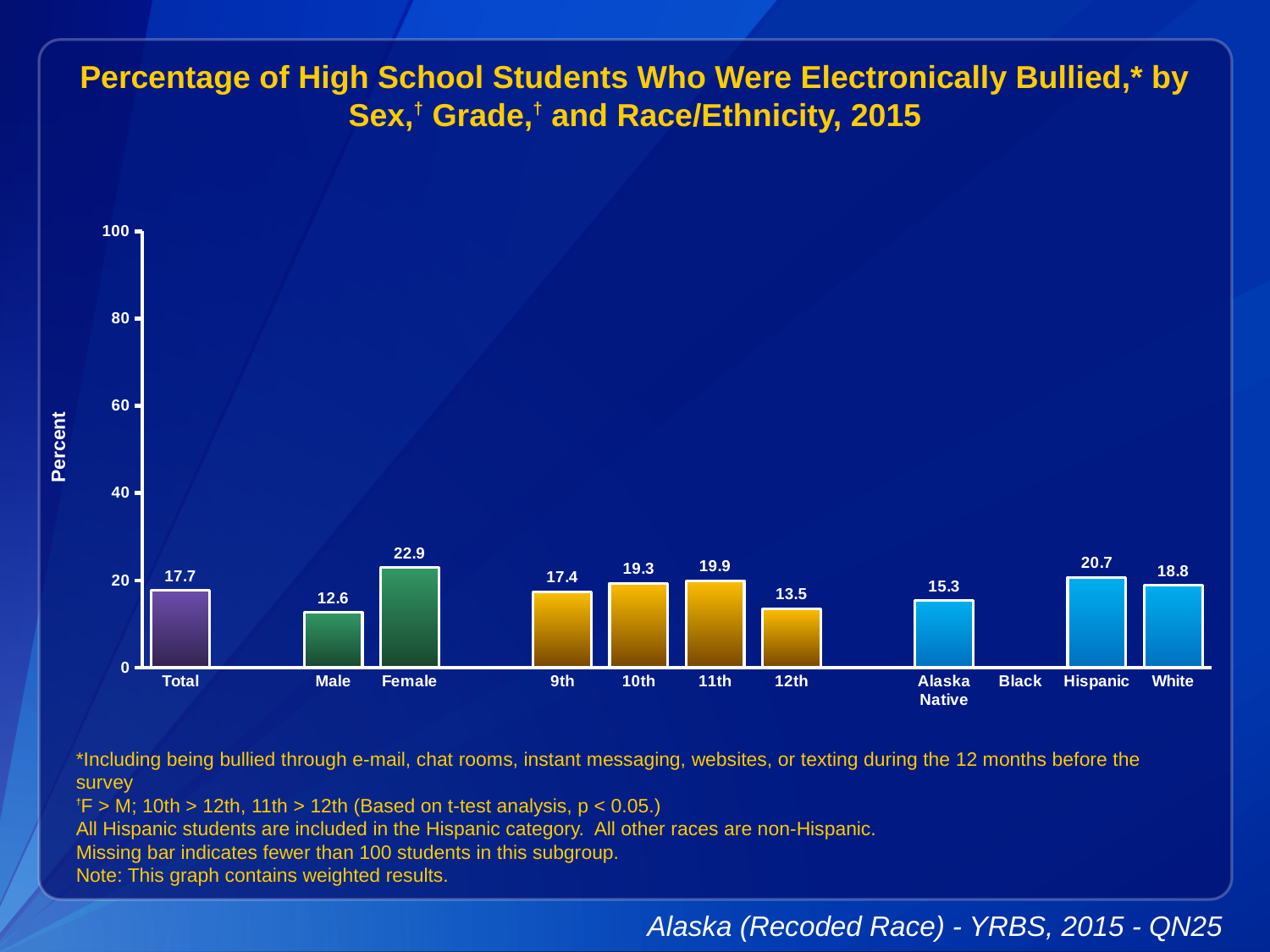
Which category has the lowest percentage of students who were electronically bullied? Male What is the value shown for Female students? 22.9 Which category has the highest percentage of students who were electronically bullied? Female What is the value shown for 12th grade students? 13.5 Is the value for 11th grade students greater or less than 20? less Which is larger, the value for Hispanic students or the value for White students? Hispanic What is the percentage of students who were electronically bullied in the Total category? 17.7 What is the difference between the Female and Male percentages? 10.3 Which race/ethnicity category has no bar shown on the chart? Black What kind of chart is shown on the slide? bar chart How many bars are plotted on the chart? 10 What is the value shown for Alaska Native students? 15.3